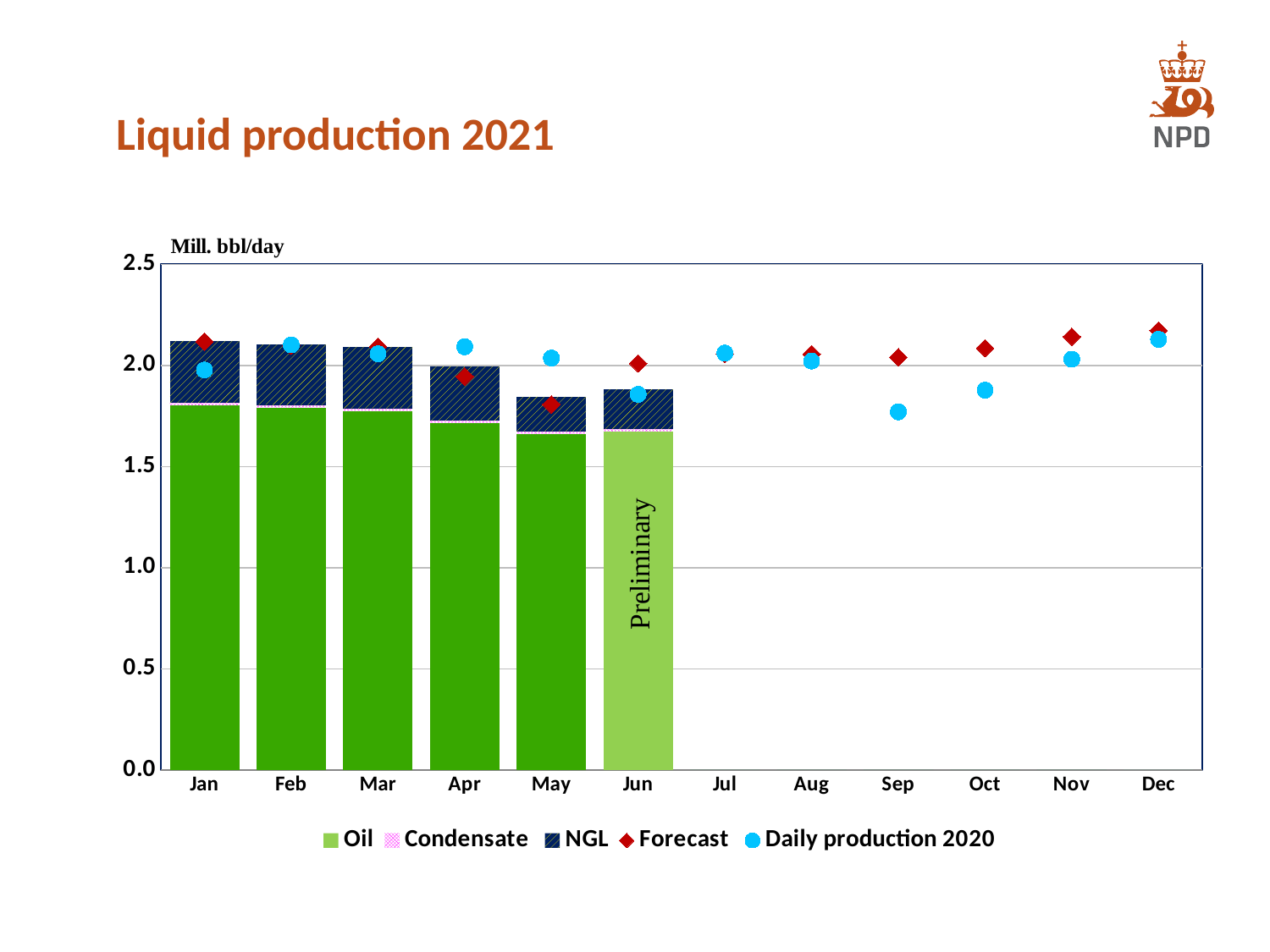
What kind of chart is this? Combination chart with stacked bars and point markers Is the Daily production 2020 value for Sep greater or less than 2.0? less Which month has the highest Forecast value? Dec How many series does the legend list? 5 How many months have stacked bars plotted? 6 In Sep, which is larger: the Forecast value or the Daily production 2020 value? Forecast How many months are shown on the x axis? 12 Which month has the lowest Daily production 2020 value? Sep Is the total stacked bar for Jan greater or less than 2.0? greater Is the total stacked bar for May greater or less than 2.0? less What unit is shown on the vertical axis of the chart? Mill. bbl/day What is the title of the chart? Liquid production 2021